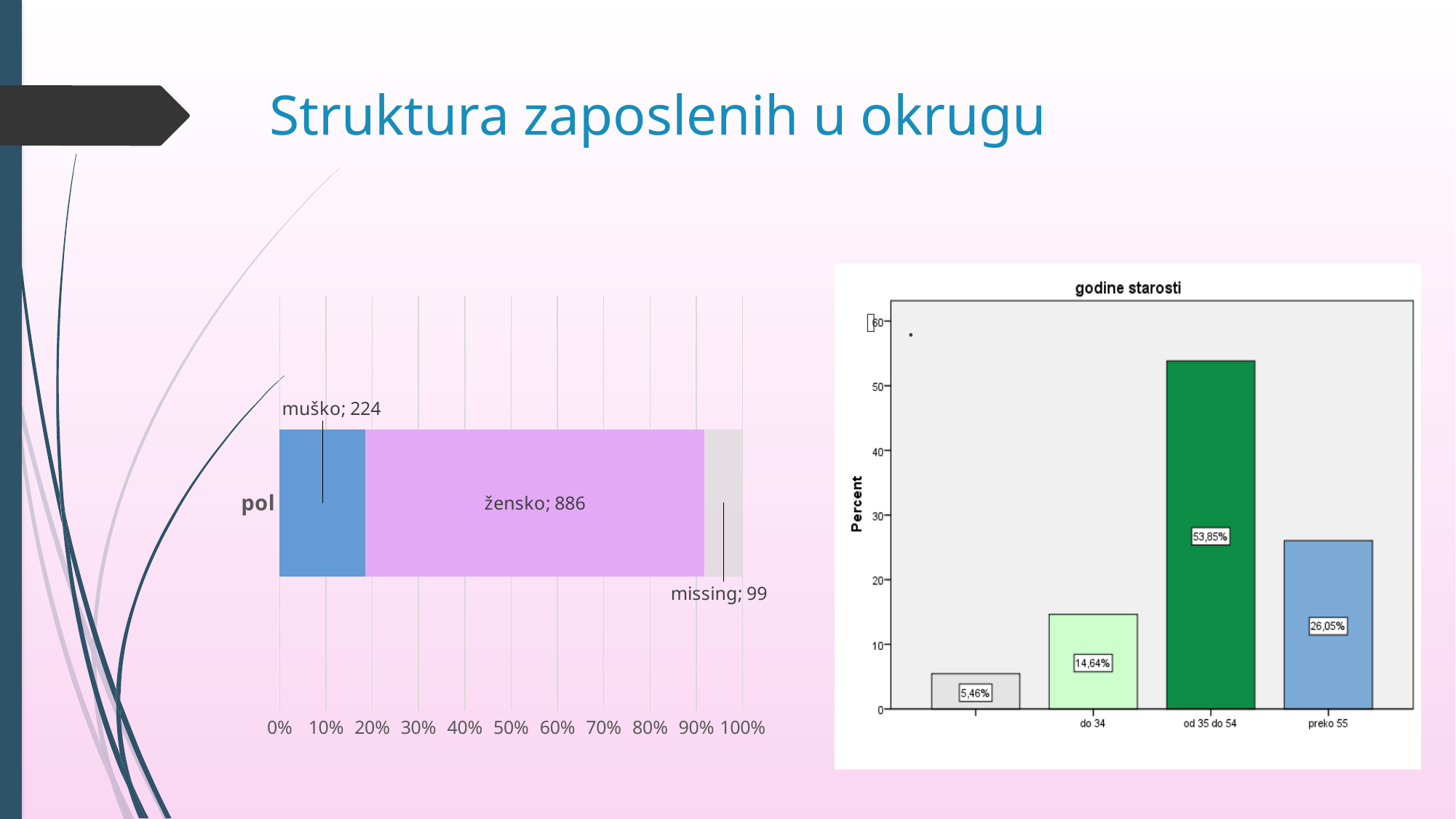
In the left chart (pol), what is the value for missing? 99 In the left chart (pol), what is the value for žensko? 886 In the right chart (godine starosti), what is the value for od 35 do 54? 53,85% In the left chart (pol), what kind of chart is shown? stacked bar chart In the right chart (godine starosti), what is the label of the y axis? Percent In the right chart (godine starosti), what is the value for preko 55? 26,05% In the right chart (godine starosti), which labelled category has the lowest value among do 34, od 35 do 54 and preko 55? do 34 In the right chart (godine starosti), what is the difference between the values for od 35 do 54 and preko 55? 27,80% In the left chart (pol), which segment has the largest value? žensko In the left chart (pol), what is the total of the three segments in the stacked bar? 1209 In the left chart (pol), what is the difference between the žensko and muško values? 662 In the left chart (pol), what is the value for muško? 224